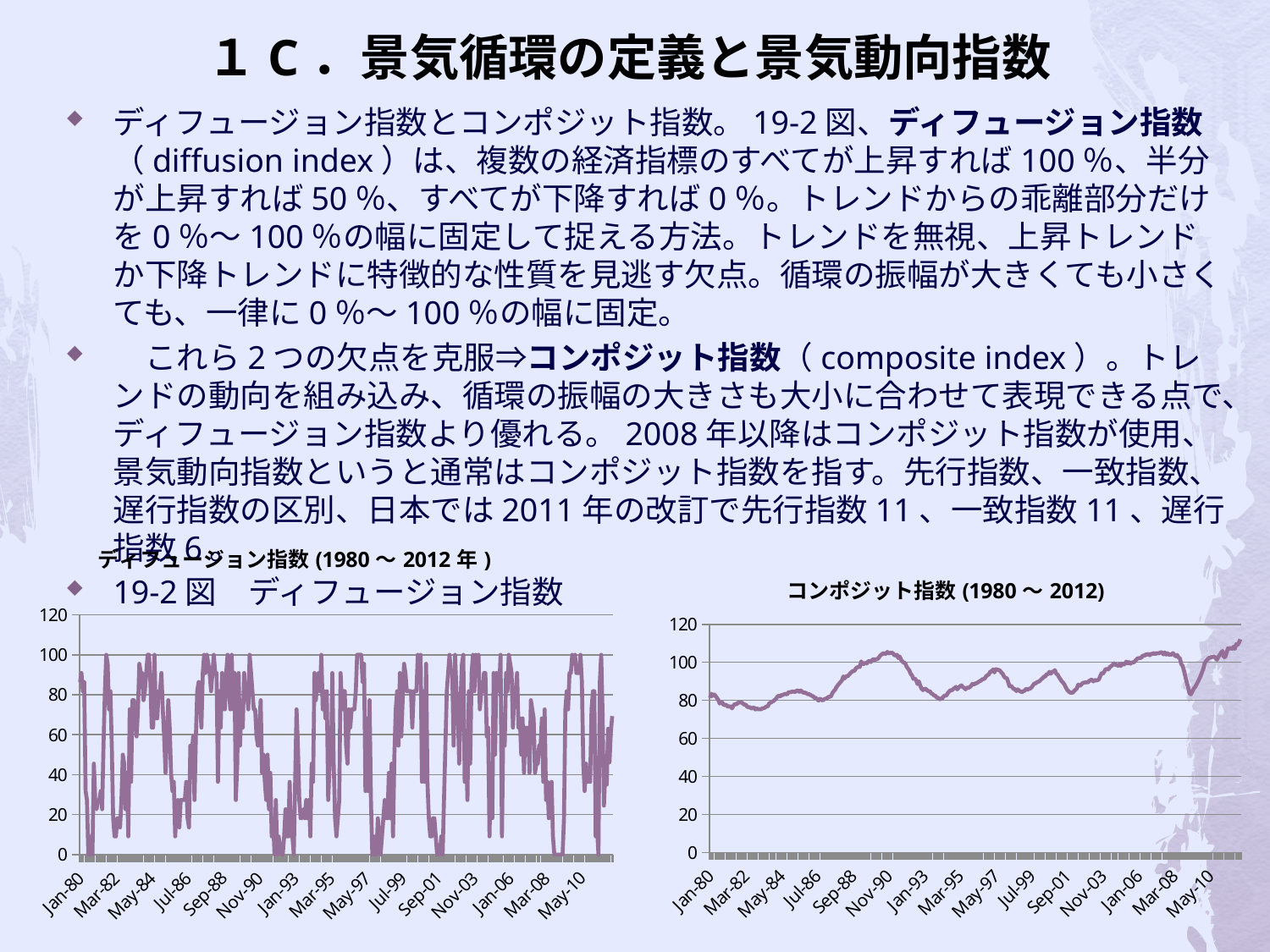
In the ディフュージョン指数 (1980 〜 2012 年) chart, what is the lowest value the line reaches? 0 In the ディフュージョン指数 (1980 〜 2012 年) chart, what is the highest value the line reaches? 100 How many date labels are shown on the horizontal axis of the コンポジット指数 (1980 〜 2012) chart? 15 In the コンポジット指数 (1980 〜 2012) chart, is the value at Jan-80 greater or less than 60? greater In the コンポジット指数 (1980 〜 2012) chart, is the value at Jan-80 greater or less than 100? less What kind of chart is the ディフュージョン指数 (1980 〜 2012 年) chart on the left? line chart In the コンポジット指数 (1980 〜 2012) chart, is the value at May-10 greater or less than 100? greater In the コンポジット指数 (1980 〜 2012) chart, does the line overall rise or fall from Jan-80 to May-10? rise What is the maximum value shown on the vertical axis of the コンポジット指数 (1980 〜 2012) chart? 120 What kind of chart is the コンポジット指数 (1980 〜 2012) chart on the right? line chart What is the title of the chart on the right side of the slide? コンポジット指数 (1980 〜 2012)